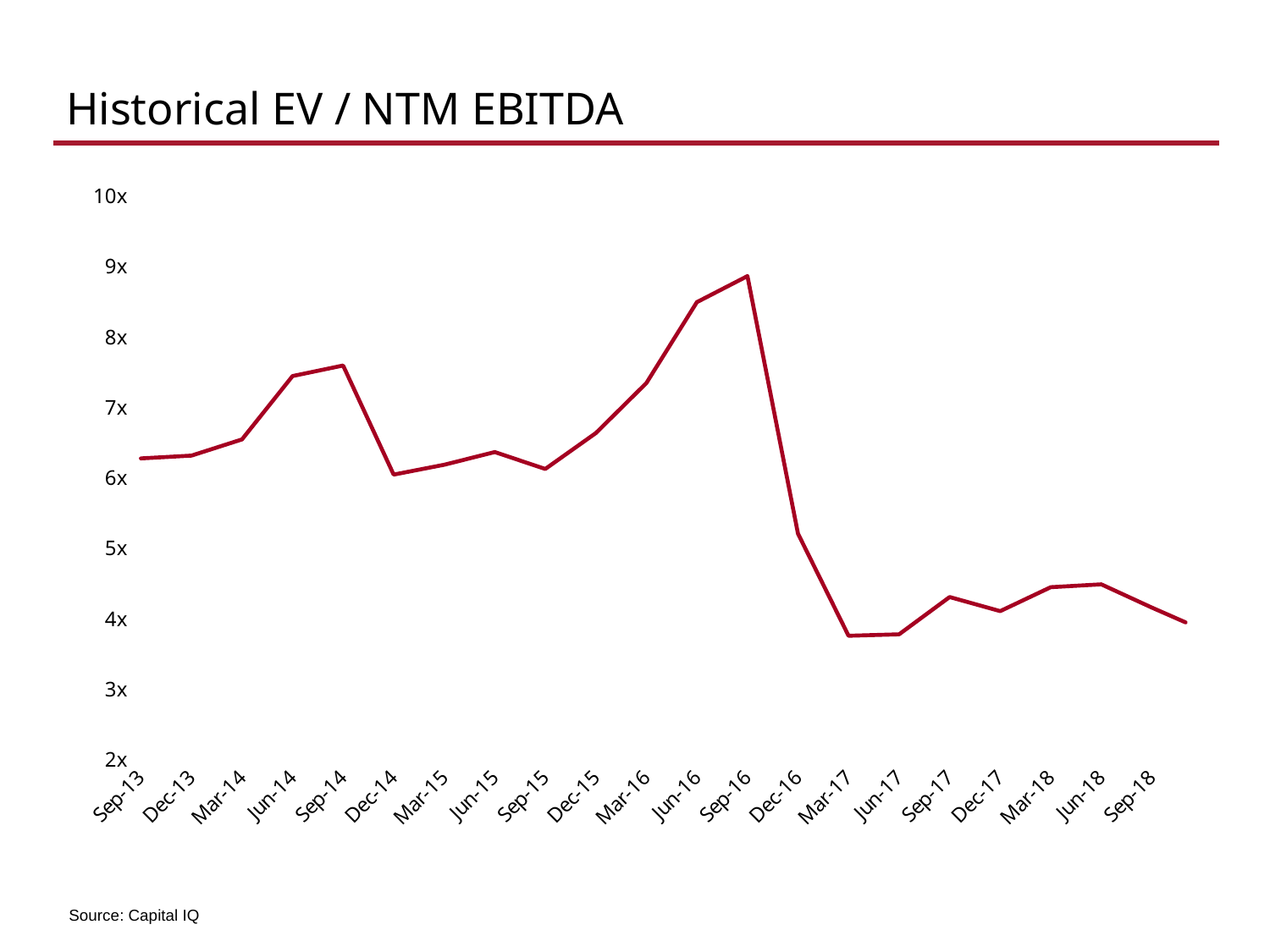
Is the value for Sep-14 greater or less than 7x? greater What is the title of the chart? Historical EV / NTM EBITDA Is the value for Mar-17 greater or less than 4x? less What source is cited for the chart? Capital IQ Which is larger, the value for Sep-16 or the value for Sep-18? Sep-16 Which is larger, the value for Sep-14 or the value for Dec-14? Sep-14 Does the multiple rise or fall between Sep-16 and Mar-17? Fall Is the value for Sep-16 greater or less than 8x? greater At which date does the EV / NTM EBITDA multiple reach its highest point? Sep-16 What kind of chart is shown on the slide? Line chart